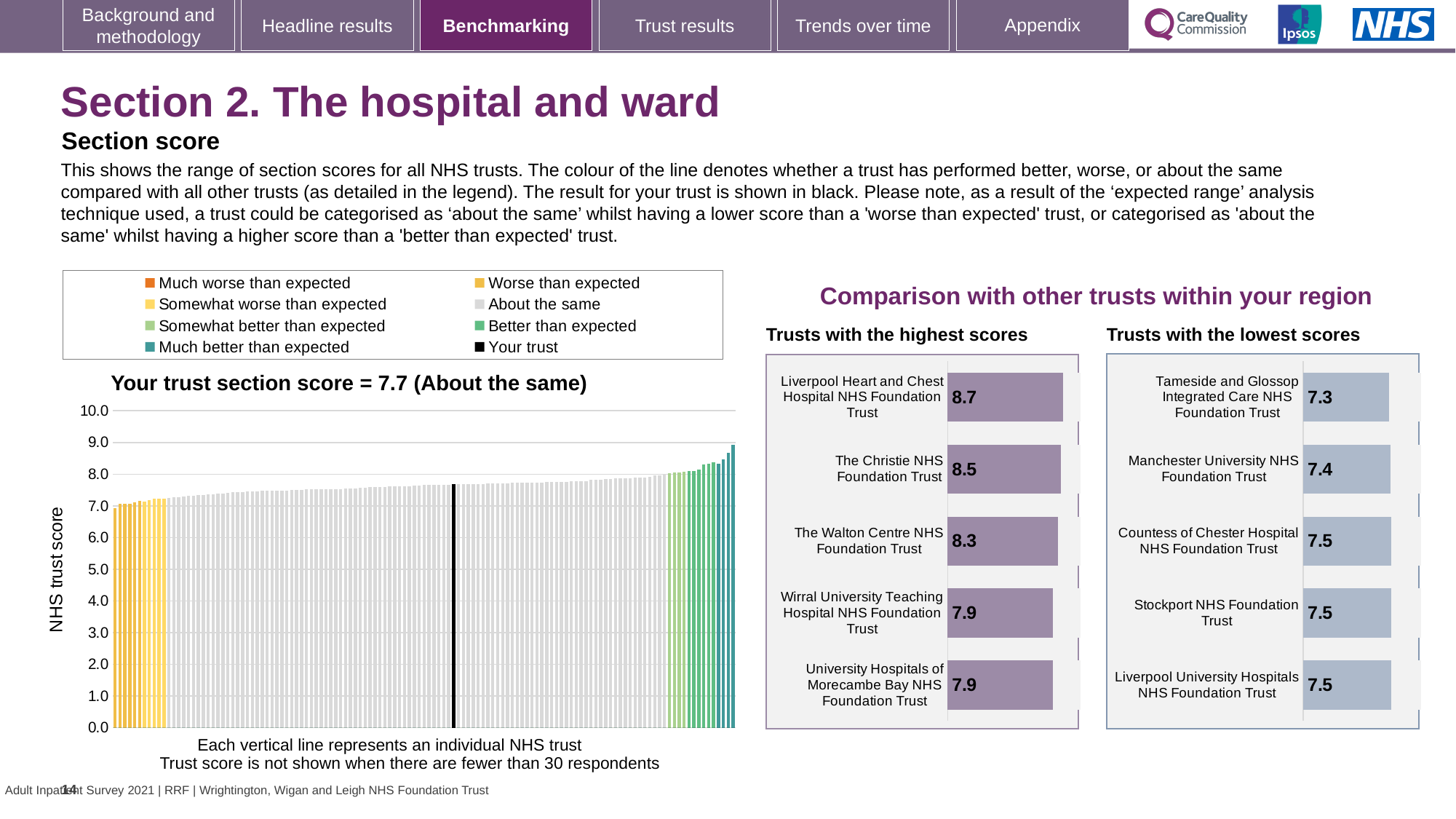
In the main section score chart on the left, is the value of the tallest bar greater or less than 8.0? greater In the 'Trusts with the lowest scores' chart, which trust has the lowest score? Tameside and Glossop Integrated Care NHS Foundation Trust In the 'Trusts with the lowest scores' chart, what is the score for Manchester University NHS Foundation Trust? 7.4 In the main section score chart on the left, do the bar values rise or fall from left to right along the x axis? rise How many entries does the legend above the main section score chart list? 8 In the 'Trusts with the highest scores' chart, which trust has the highest score? Liverpool Heart and Chest Hospital NHS Foundation Trust In the 'Trusts with the highest scores' chart, what is the difference between the scores of Liverpool Heart and Chest Hospital NHS Foundation Trust and The Christie NHS Foundation Trust? 0.2 In the main section score chart on the left, what is the section score for your trust? 7.7 In the 'Trusts with the highest scores' chart, which has the higher score: The Walton Centre NHS Foundation Trust or Wirral University Teaching Hospital NHS Foundation Trust? The Walton Centre NHS Foundation Trust In the 'Trusts with the lowest scores' chart, how many trusts are shown? 5 What kind of chart is the 'Trusts with the highest scores' chart? bar chart In the 'Trusts with the highest scores' chart, what is the score for Liverpool Heart and Chest Hospital NHS Foundation Trust? 8.7